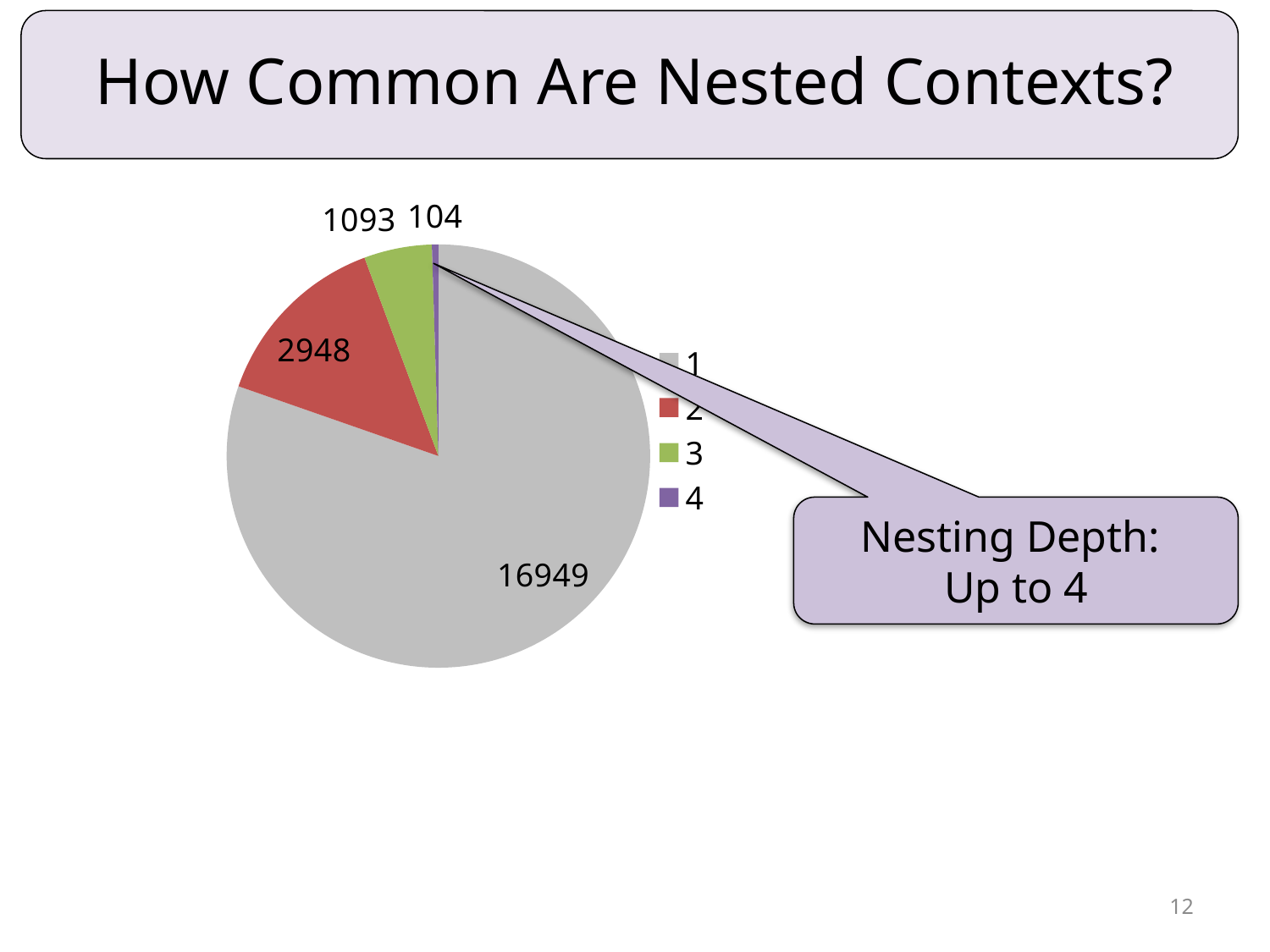
What is the difference between the values for nesting depth 3 and nesting depth 4? 989 What is the value for nesting depth 3 in the pie chart? 1093 Which nesting depth has the largest slice of the pie? 1 What is the value for nesting depth 4 in the pie chart? 104 What is the value for nesting depth 2 in the pie chart? 2948 Which nesting depth has the smallest slice of the pie? 4 What colour is the slice for nesting depth 3? green What is the value for nesting depth 1 in the pie chart? 16949 What is the difference between the values for nesting depth 1 and nesting depth 2? 14001 How many slices does the pie chart have? 4 What kind of chart is shown on the slide? pie chart Which is larger, the value for nesting depth 2 or nesting depth 3? nesting depth 2